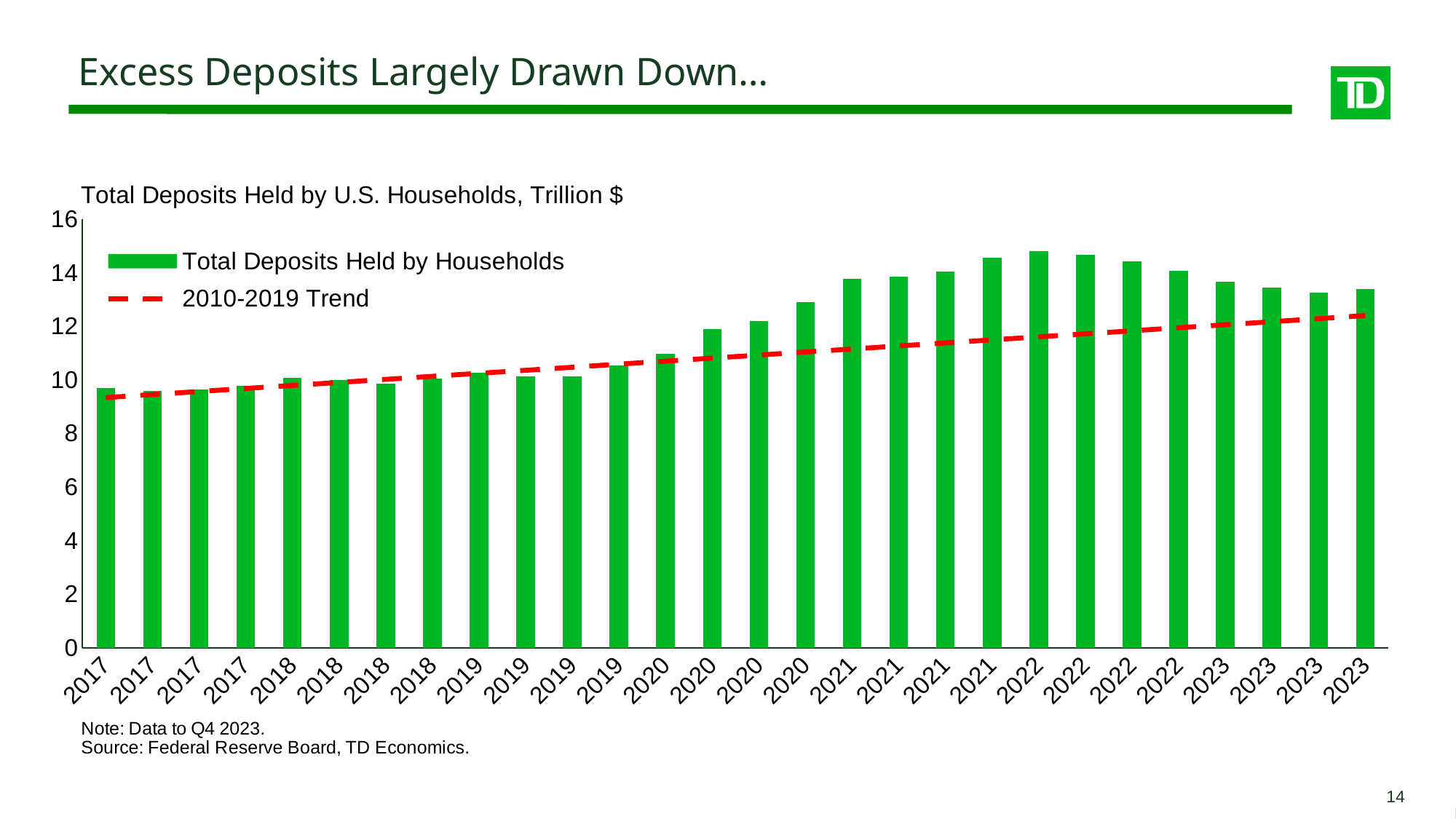
Is the value of the tallest 2022 bar greater or less than 14? greater Do the bars rise or fall from the first 2017 bar to the first 2021 bar? rise Is the value of the last 2023 bar greater or less than 12? greater In which year does the shortest bar occur? 2017 What kind of chart is shown on the slide? combination bar and line chart In which year does the tallest bar occur? 2022 What is the title of the chart? Total Deposits Held by U.S. Households, Trillion $ How many distinct years appear on the x axis? 7 How many entries does the legend list? 2 Which is larger, the first 2017 bar or the last 2023 bar? the last 2023 bar Is the value of the first 2017 bar greater or less than 10? less How many bars are plotted in the chart? 28